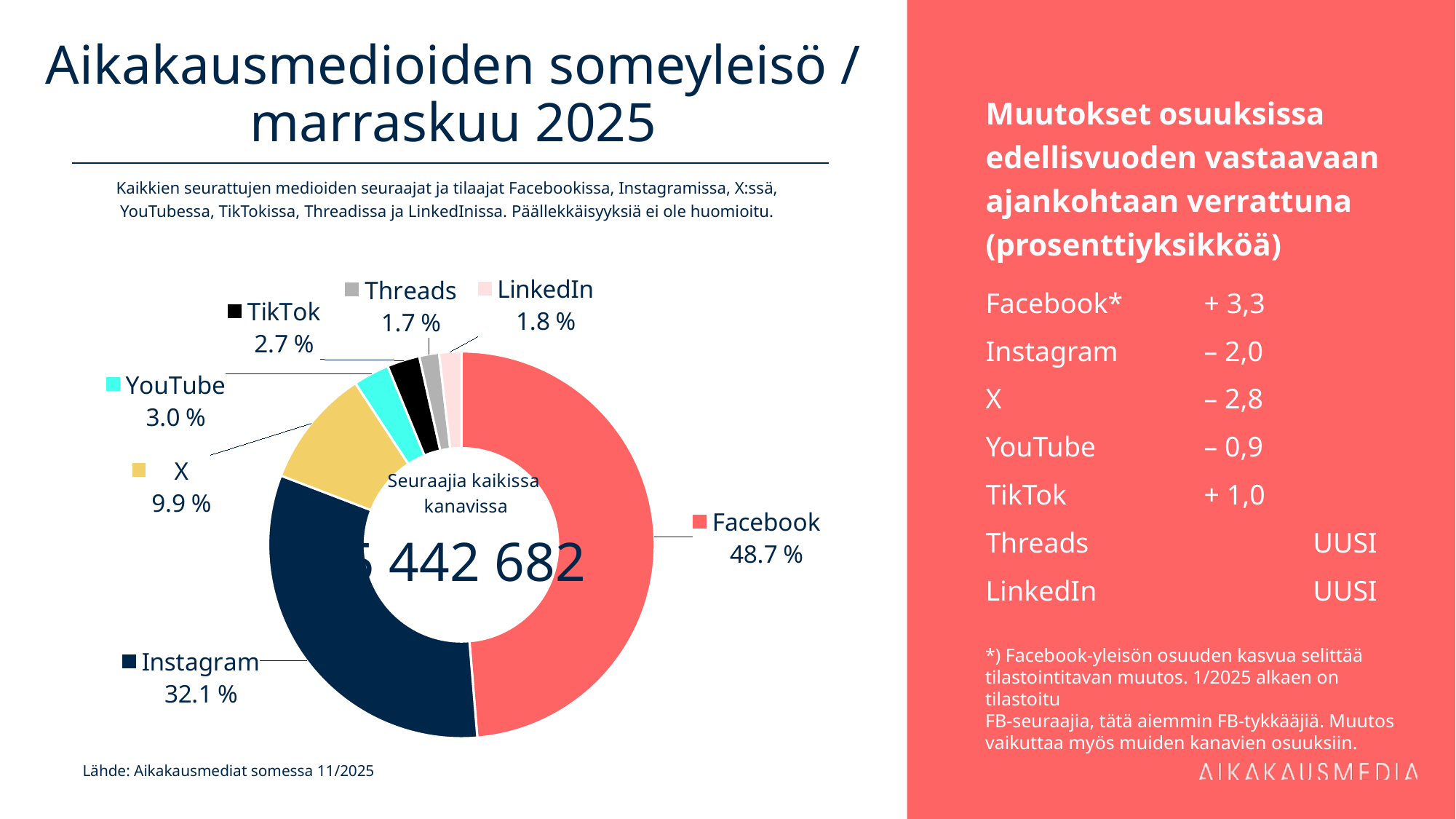
Which has a larger share, TikTok or YouTube? YouTube What share of the social media audience does Facebook have? 48.7 % How many channels are shown in the chart? 7 What colour is the Instagram segment in the chart? Dark navy blue What share does Instagram have in the chart? 32.1 % What share is shown for YouTube? 3.0 % What kind of chart is shown on the slide? Doughnut chart Which channel has the smallest share in the chart? Threads What share is shown for LinkedIn? 1.8 % What is the difference in percentage points between Facebook's and Instagram's shares? 16.6 What is the share shown for X? 9.9 % Which channel has the largest share in the chart? Facebook